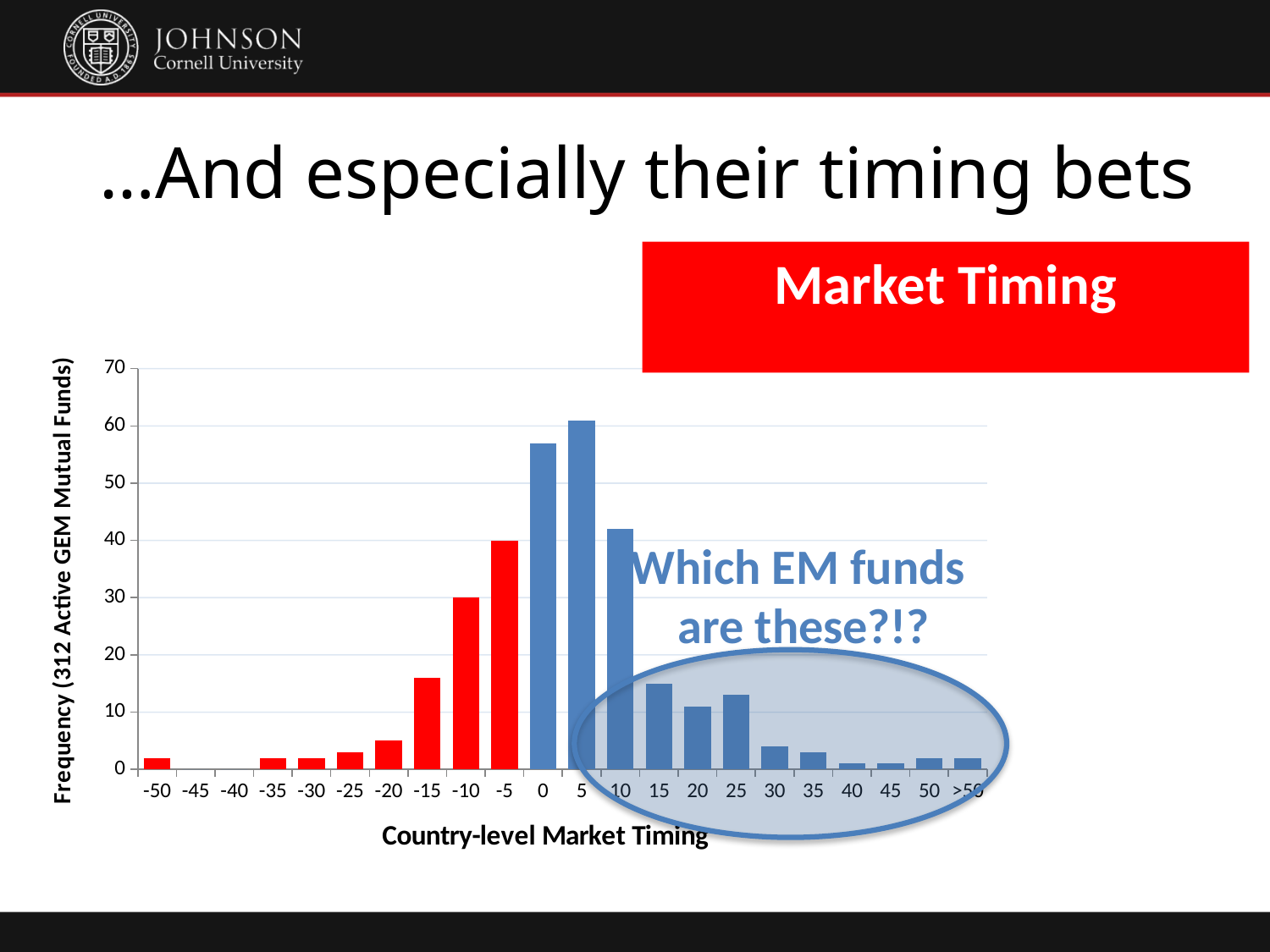
Is the frequency for the 10 category greater or less than 30? greater Is the frequency for the -15 category greater or less than 10? greater How many Country-level Market Timing categories are shown on the x axis? 22 What is the frequency for the -10 category? 30 Which Country-level Market Timing category has the highest frequency? 5 Is the frequency for the 30 category greater or less than 10? less Which has the higher frequency, the -10 category or the 15 category? -10 What is the title of the x axis? Country-level Market Timing Do the frequencies rise or fall as the x axis moves from -50 to 5? rise What kind of chart is shown on the slide? bar chart What is the frequency for the -5 category? 40